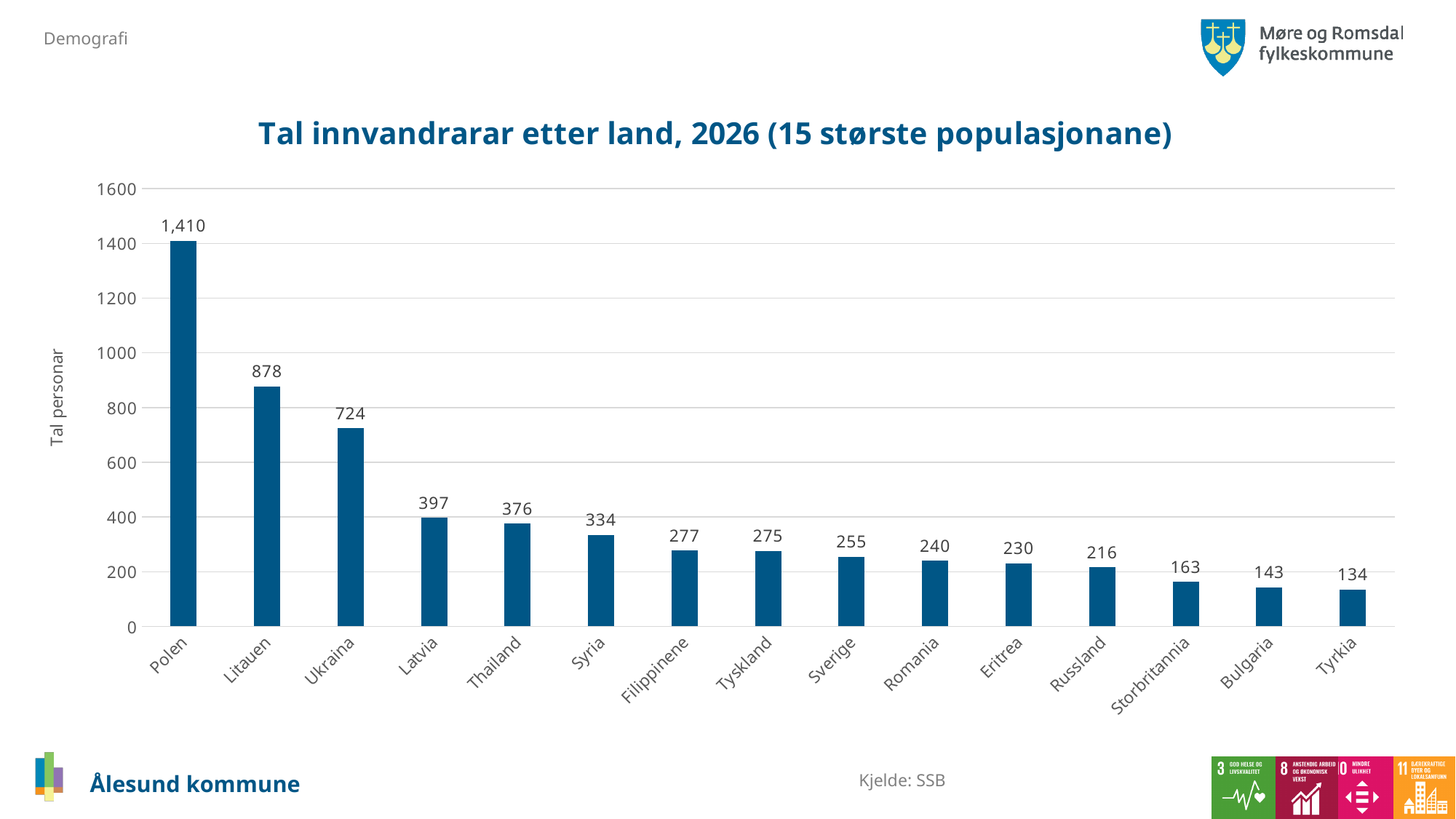
What is the value for Thailand? 376 What is the value for Polen? 1,410 What is the difference between the values for Latvia and Syria? 63 What is the value for Storbritannia? 163 What is the title of the chart? Tal innvandrarar etter land, 2026 (15 største populasjonane) What is the difference between the values for Litauen and Ukraina? 154 Which country has the lowest value? Tyrkia Which is larger, the value for Sverige or the value for Eritrea? Sverige Is the value for Ukraina greater or less than 600? greater Which country has the highest value? Polen What kind of chart is this? Bar chart How many countries are shown on the x axis? 15